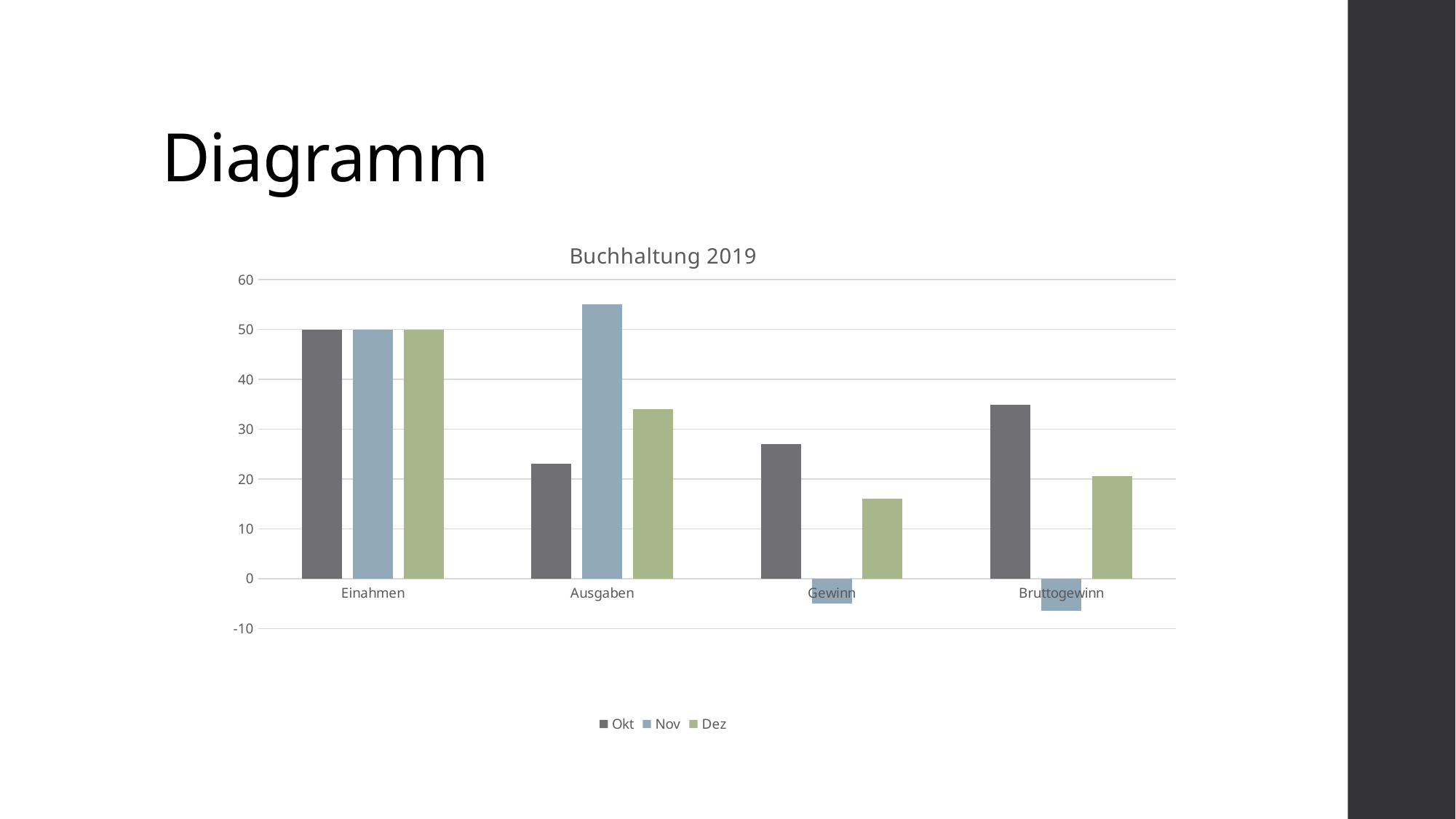
What is the value for Okt in the Einahmen category? 50 Which series has the lowest value in the Bruttogewinn category? Nov Which series has the highest value in the Ausgaben category? Nov How many categories are shown on the x axis? 4 What is the value for Dez in the Einahmen category? 50 Is the value for Okt in the Bruttogewinn category greater or less than 30? greater Is the value for Nov in the Gewinn category greater or less than 0? less In the Ausgaben category, which is larger: the value for Okt or the value for Dez? Dez What is the title of the chart? Buchhaltung 2019 Is the value for Nov in the Ausgaben category greater or less than 50? greater How many series does the legend list? 3 What kind of chart is shown on the slide? bar chart